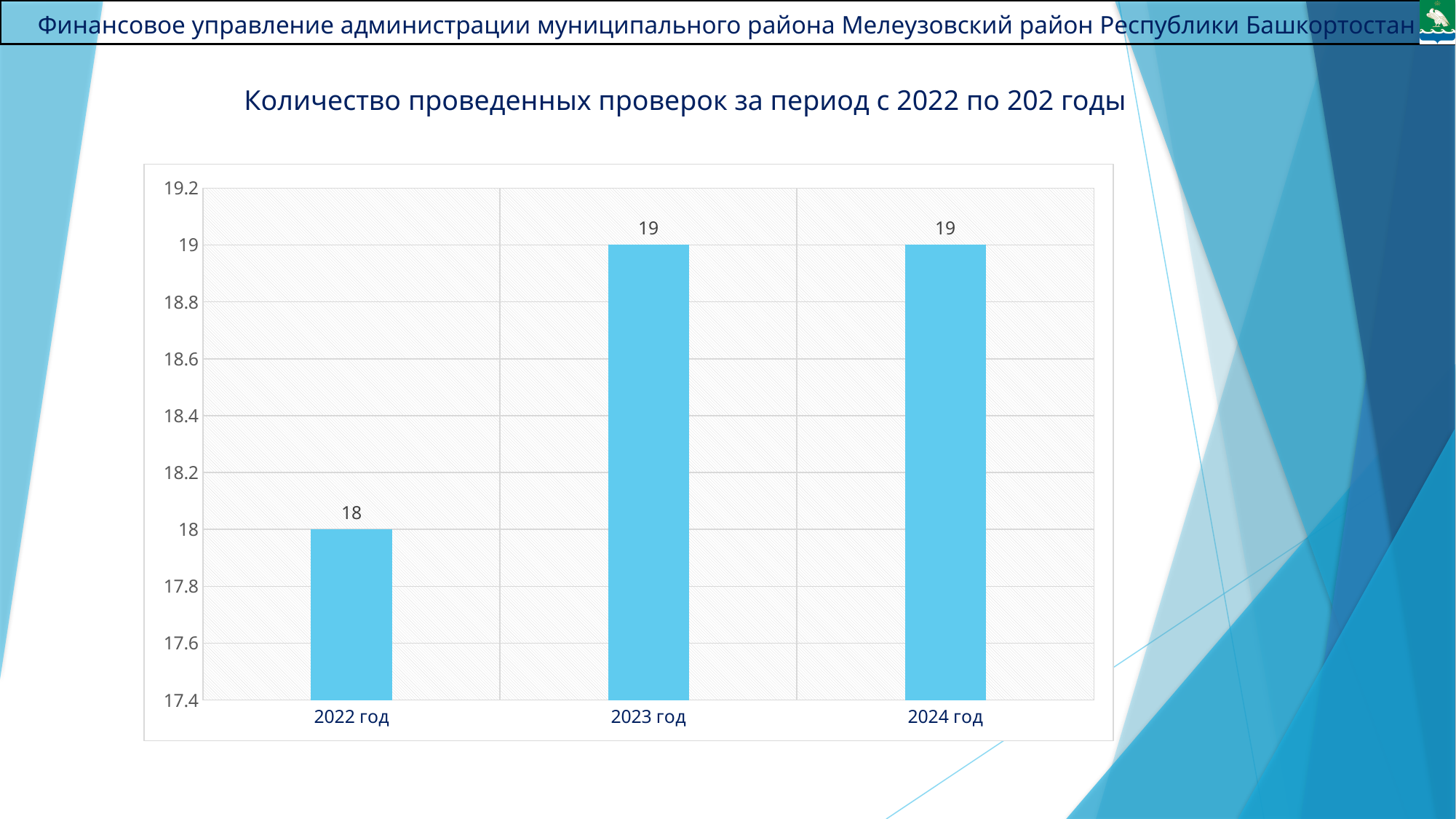
Is the value for 2023 год greater or less than 18.6? greater What is the value for 2022 год? 18 What is the value for 2024 год? 19 What is the value for 2023 год? 19 How many categories are shown on the x axis? 3 What is the title of the chart? Количество проведенных проверок за период с 2022 по 202 годы What is the difference between the values for 2023 год and 2022 год? 1 Which year has the lowest value? 2022 год Do the values rise or fall from 2022 год to 2023 год? rise Is the value for 2022 год greater or less than 18.4? less Which is larger, the value for 2022 год or the value for 2024 год? 2024 год What kind of chart is shown on the slide? bar chart